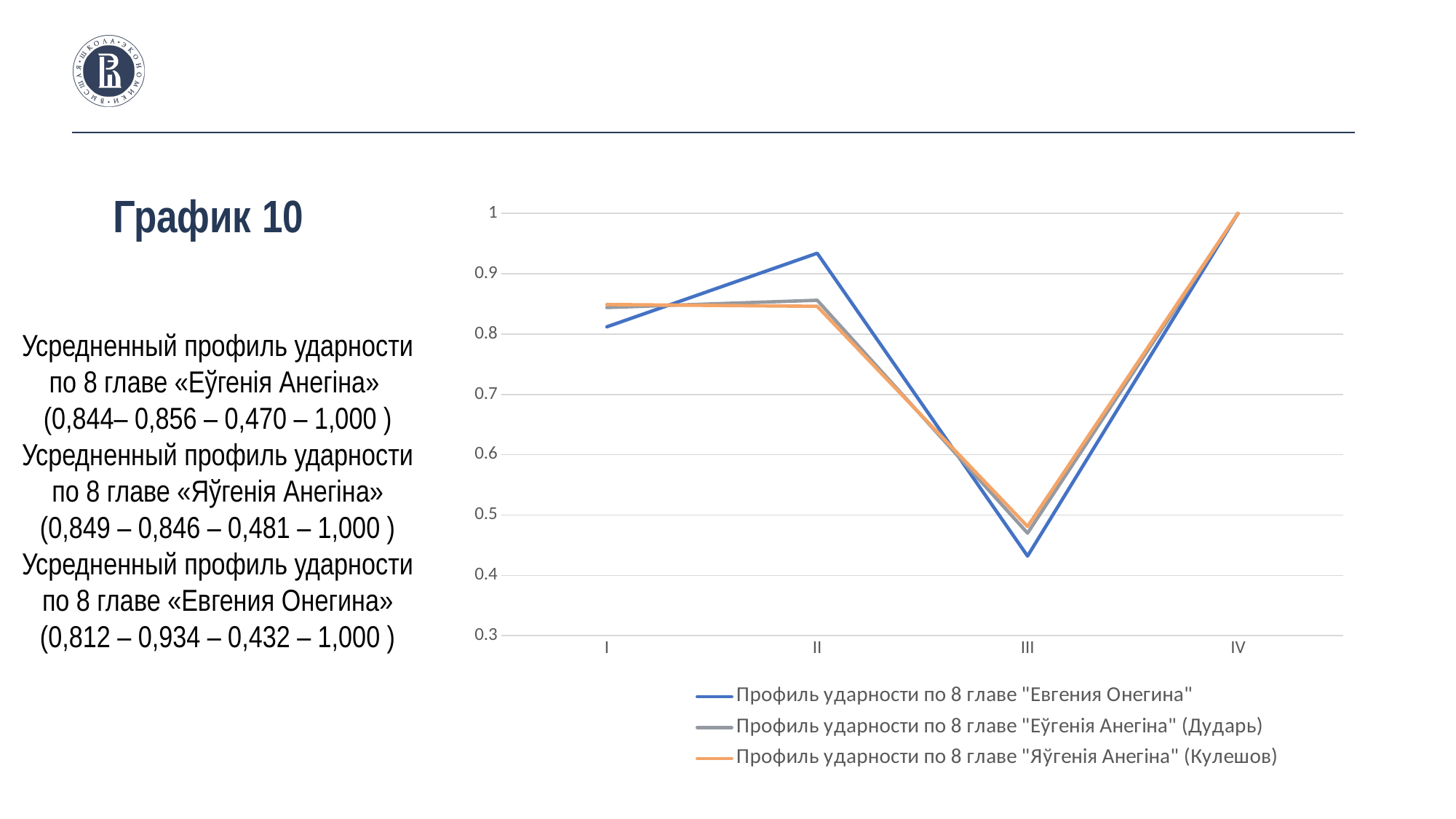
What kind of chart is shown on the slide? line chart Is the value of the "Еўгенія Анегіна" (Дударь) series at point I greater or less than 0.8? greater Which series reaches the highest value at point II? Профиль ударности по 8 главе "Евгения Онегина" Is the value of the "Евгения Онегина" series at point III greater or less than 0.5? less Is the value of the "Евгения Онегина" series at point II greater or less than 0.9? greater At point I, is the "Евгения Онегина" series higher or lower than the "Яўгенія Анегіна" (Кулешов) series? lower Which series has the lowest value at point III? Профиль ударности по 8 главе "Евгения Онегина" How many points are plotted along the x axis for each series? 4 Do the values of all series rise or fall from point III to point IV? rise According to the text on the slide, what is the value of the averaged profile for «Евгения Онегина» at point II? 0,934 What is the title of the slide? График 10 How many series does the legend list? 3